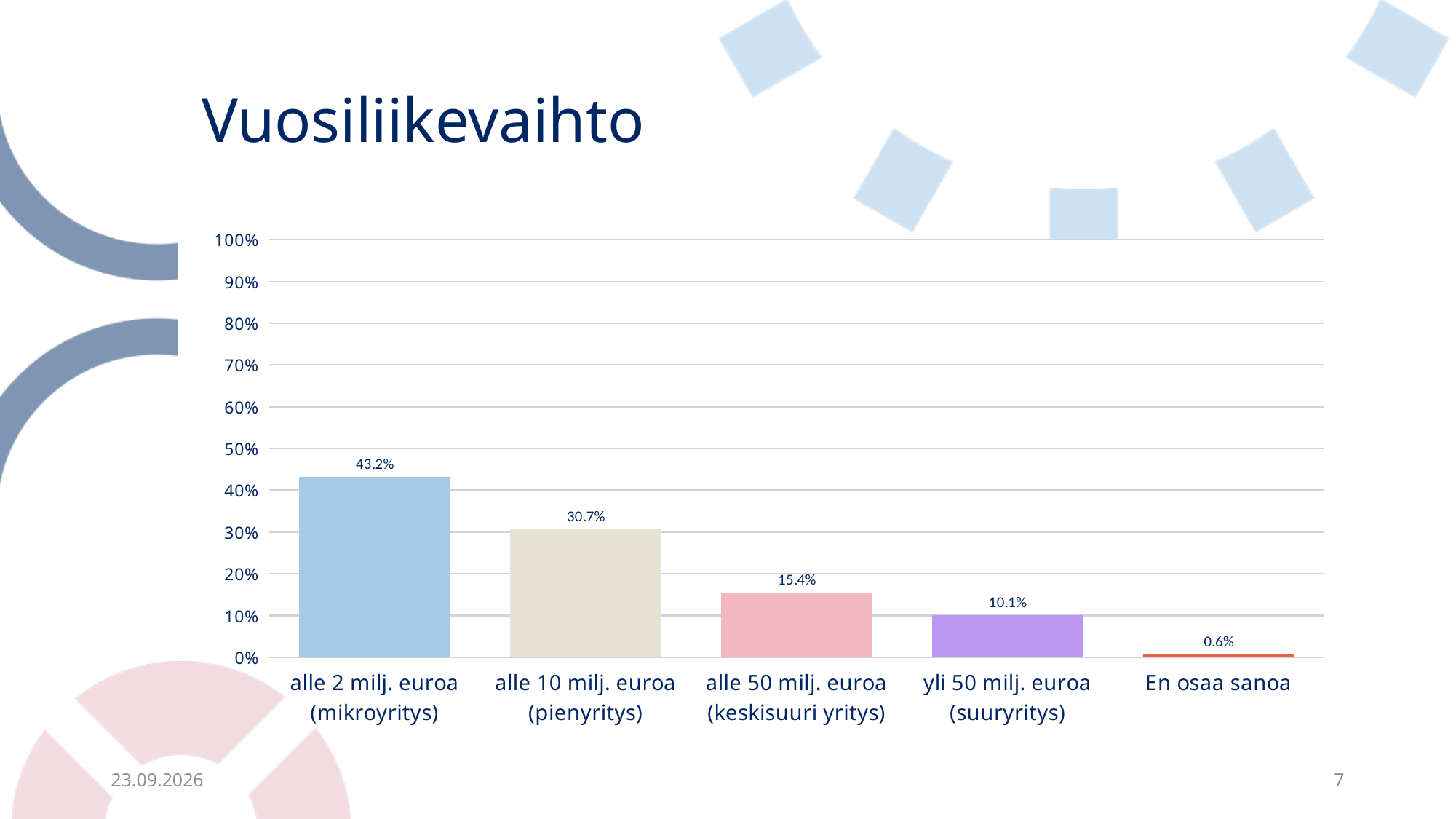
Which category has the lowest value? En osaa sanoa What is the value for 'alle 10 milj. euroa (pienyritys)'? 30.7% What kind of chart is shown on the slide? bar chart How many categories are shown on the x axis? 5 Is the value for 'yli 50 milj. euroa (suuryritys)' greater or less than 20%? less What is the title of the slide? Vuosiliikevaihto What is the value for 'En osaa sanoa'? 0.6% What is the difference between the values for 'alle 2 milj. euroa (mikroyritys)' and 'alle 10 milj. euroa (pienyritys)'? 12.5% Which category has the highest value? alle 2 milj. euroa (mikroyritys) What is the value for 'alle 2 milj. euroa (mikroyritys)'? 43.2% What is the value for 'alle 50 milj. euroa (keskisuuri yritys)'? 15.4% Which is larger, the value for 'alle 50 milj. euroa (keskisuuri yritys)' or 'yli 50 milj. euroa (suuryritys)'? alle 50 milj. euroa (keskisuuri yritys)